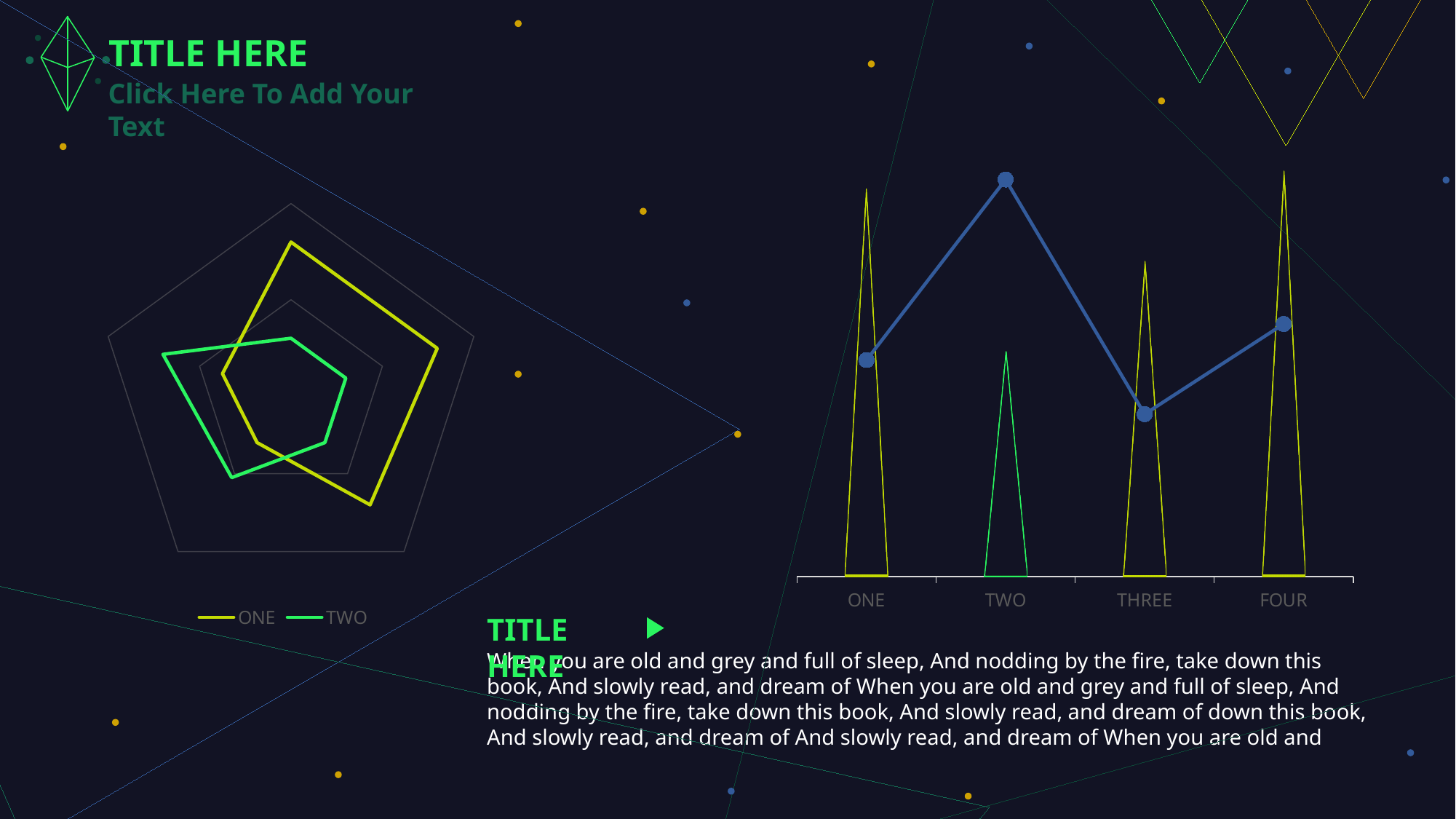
In the chart on the right, which spike-shaped bar is taller, ONE or THREE? ONE In the chart on the right, at which category does the line series reach its lowest point? THREE In the chart on the right, does the line series rise or fall from TWO to THREE? Fall In the chart on the right, which category has the tallest spike-shaped bar? FOUR How many series does the legend of the left chart list? 2 In the chart on the right, which category has the shortest spike-shaped bar? TWO What are the two series named in the legend of the left chart? ONE and TWO What kind of chart is the chart on the left of the slide? Radar chart In the left radar chart, which series is drawn in green? TWO In the chart on the right, at which category does the line series reach its highest point? TWO How many categories are shown on the x axis of the chart on the right? 4 In the left radar chart, which series extends further from the centre overall, ONE or TWO? ONE